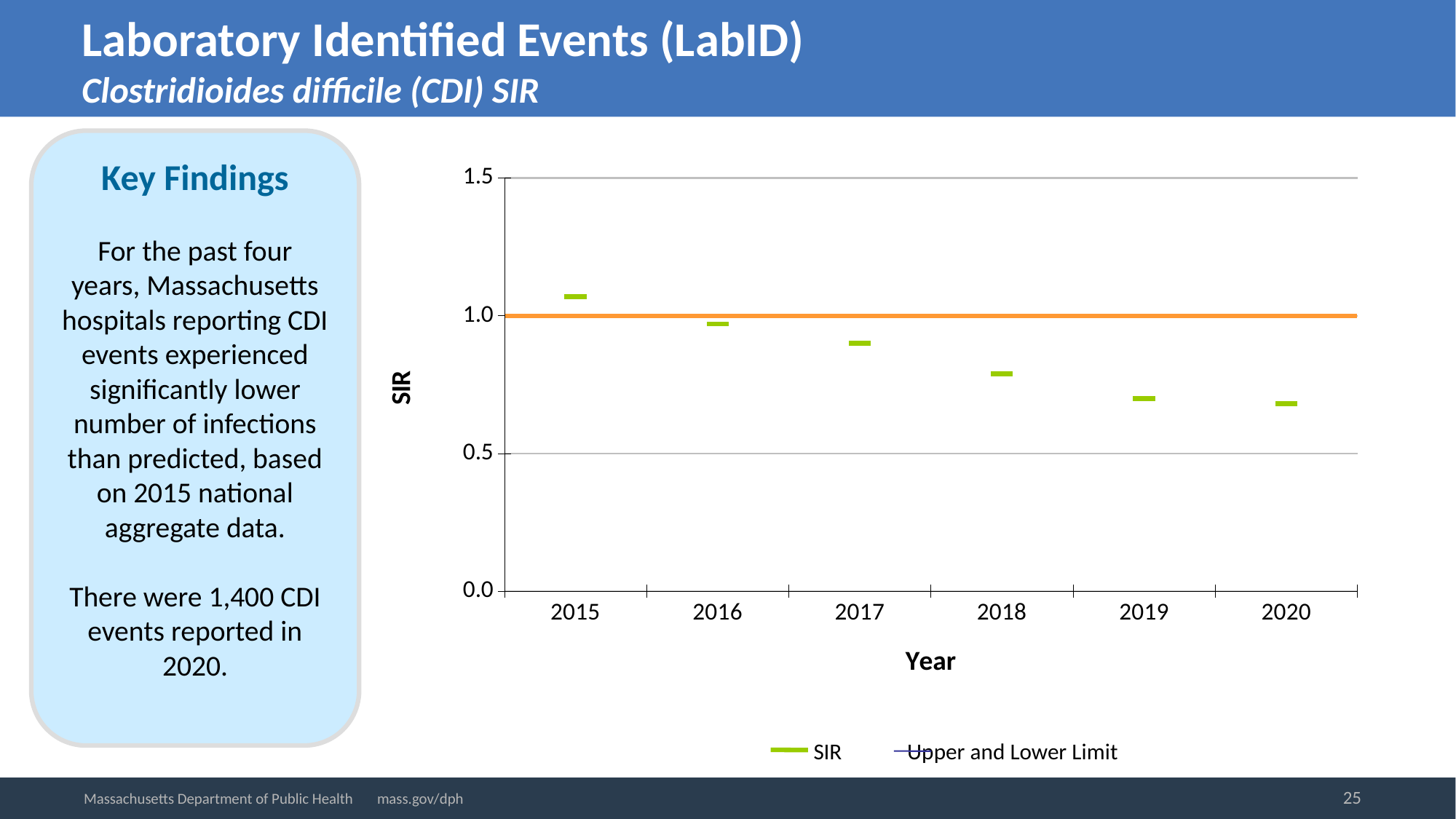
Is the SIR value for 2020 greater or less than 1.0? less Which is larger, the SIR value for 2015 or for 2018? 2015 Which year has the highest SIR value? 2015 What is the label of the x axis? Year What is the label of the y axis? SIR Is the SIR value for 2018 greater or less than 0.5? greater How many years are plotted on the x axis? 6 Is the SIR value for 2016 greater or less than 1.0? less Which is larger, the SIR value for 2016 or for 2020? 2016 Do the SIR values rise or fall from 2015 to 2020? fall How many series does the legend list? 2